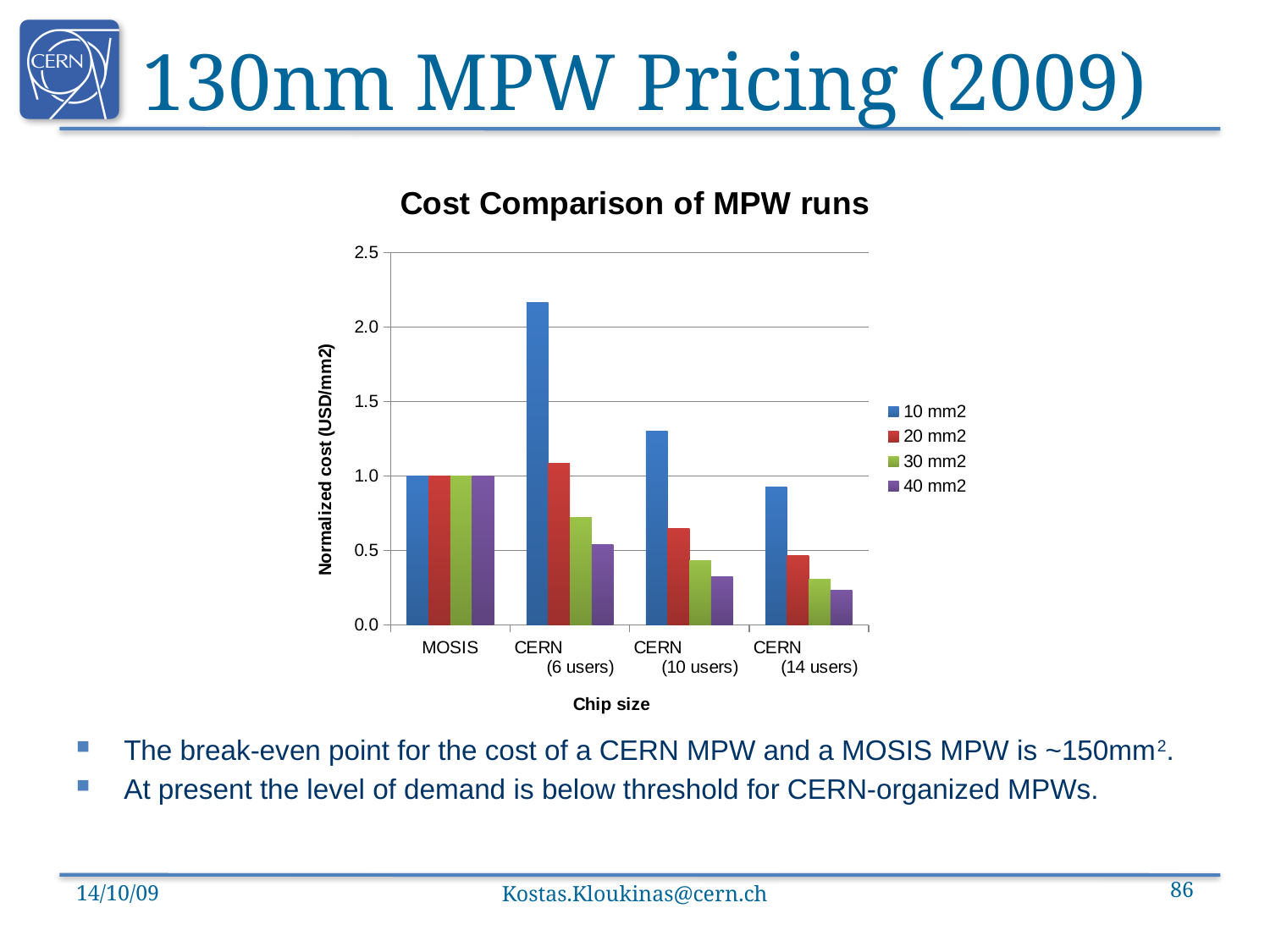
How many series does the legend list? 4 Is the 10 mm2 value for CERN (14 users) greater or less than 1.0? less Do the 10 mm2 values rise or fall from CERN (6 users) to CERN (14 users)? fall How many categories are shown on the x axis? 4 What is the title of the chart? Cost Comparison of MPW runs Which category has the lowest bar in the 40 mm2 series? CERN (14 users) Which is larger: the 10 mm2 value for CERN (6 users) or the 10 mm2 value for CERN (10 users)? CERN (6 users) What is the normalized cost for MOSIS in the 10 mm2 series? 1.0 Is the 10 mm2 value for CERN (6 users) greater or less than 2.0? greater What is the normalized cost for MOSIS in the 40 mm2 series? 1.0 What type of chart is shown on the slide? bar chart Which category has the highest bar in the 10 mm2 series? CERN (6 users)